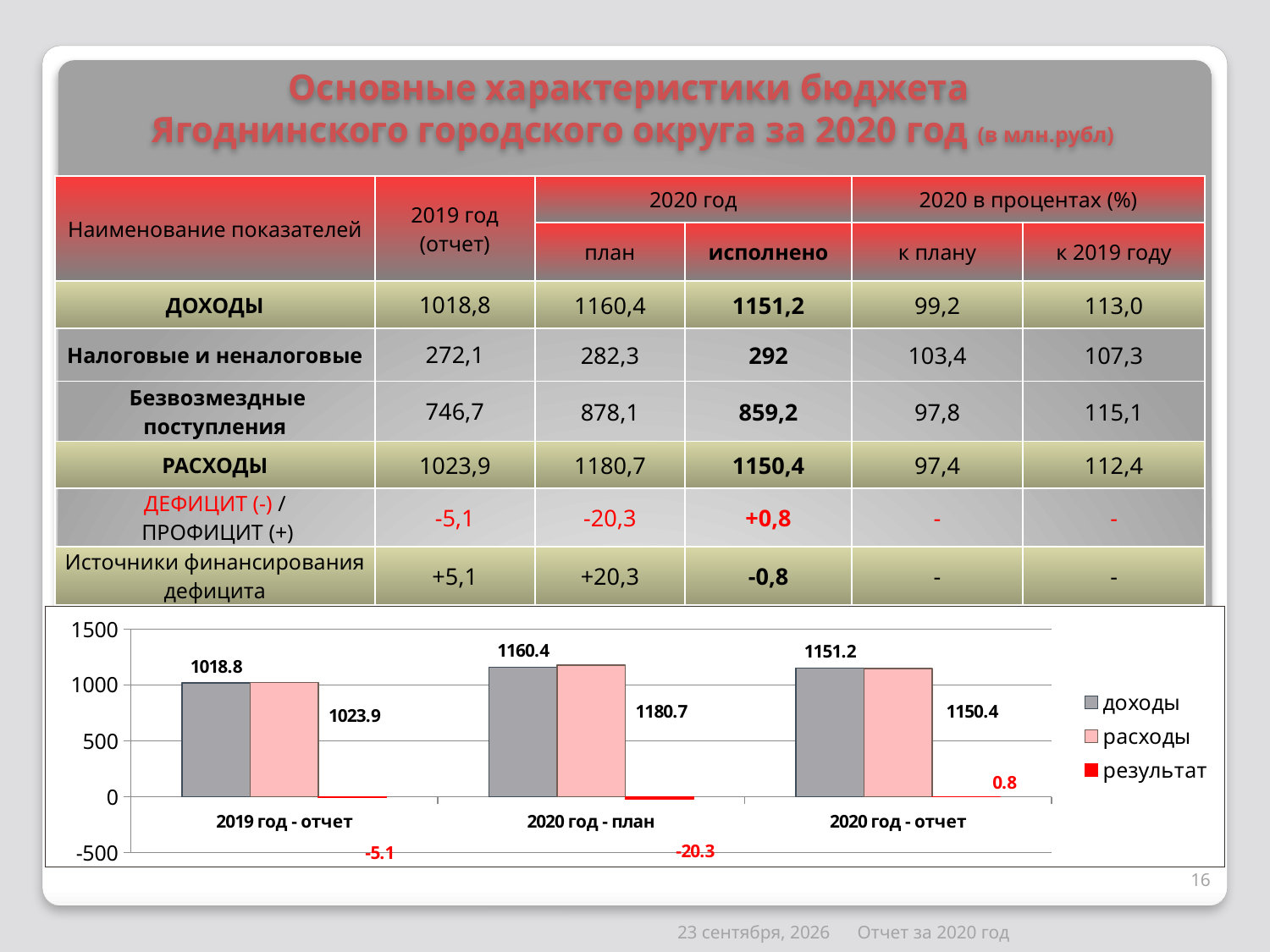
What is the value of результат for 2020 год - отчет in the chart? 0.8 Which series in the chart legend is shown in red? результат What is the value of результат for 2020 год - план in the chart? -20.3 In which category is the расходы value highest in the chart? 2020 год - план What is the value of расходы for 2020 год - план in the chart? 1180.7 Which is larger in the chart for 2019 год - отчет: доходы or расходы? расходы What kind of chart is shown at the bottom of the slide? bar chart How many series does the chart legend list? 3 How many categories are shown on the x axis of the chart? 3 What is the value of доходы for 2019 год - отчет in the chart? 1018.8 In which category is the результат value lowest in the chart? 2020 год - план What is the difference between расходы and доходы for 2020 год - план in the chart? 20.3